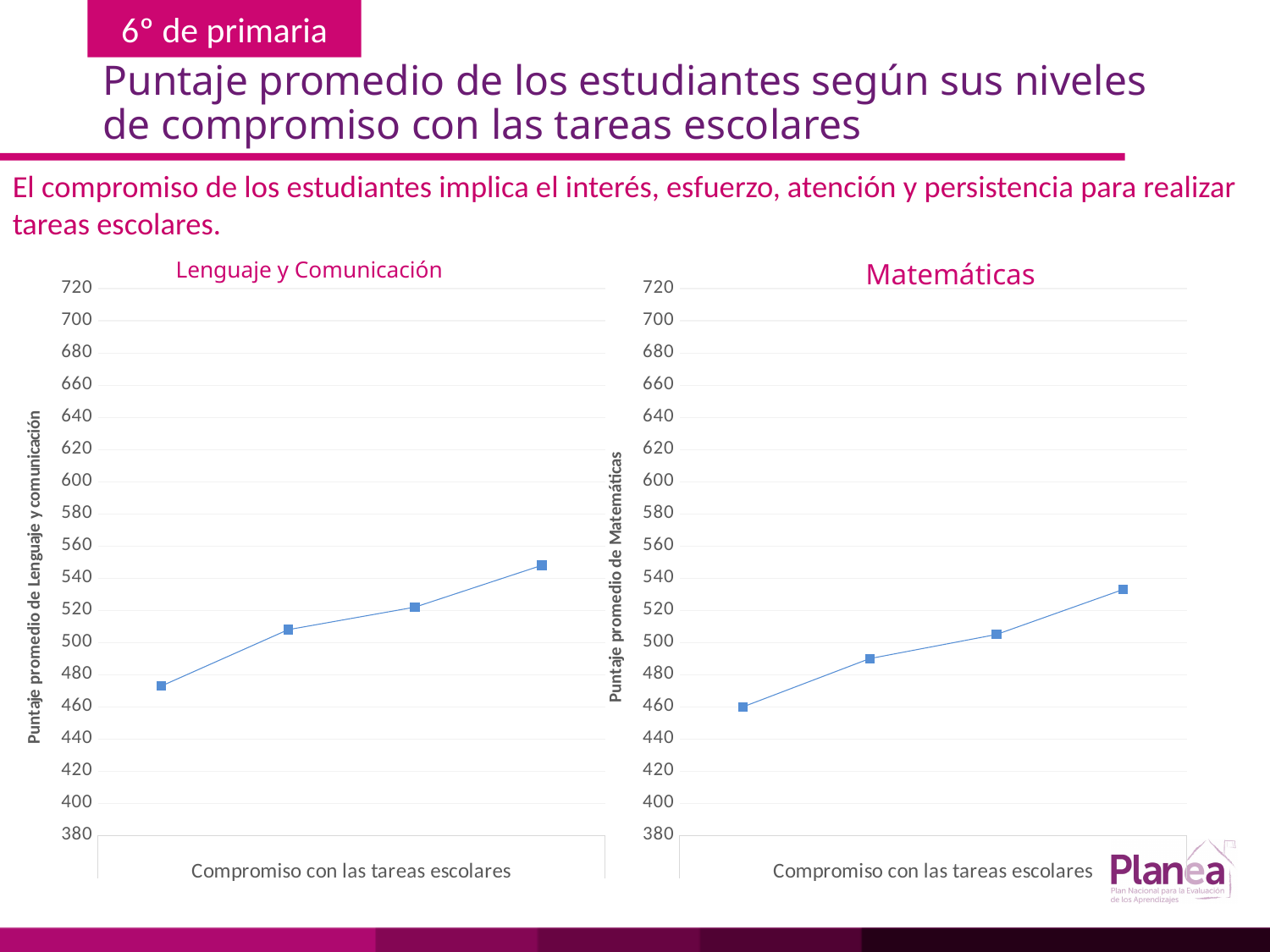
How many data points are plotted in the 'Lenguaje y Comunicación' chart? 4 How many data points are plotted in the 'Matemáticas' chart? 4 In the 'Matemáticas' chart, is the value of the second point from the left greater or less than 480? greater In the 'Matemáticas' chart, do the values rise or fall from left to right along the x axis? rise Which chart has the higher rightmost point, 'Lenguaje y Comunicación' or 'Matemáticas'? Lenguaje y Comunicación What kind of chart is the 'Lenguaje y Comunicación' chart? line chart What is the y-axis label of the 'Lenguaje y Comunicación' chart? Puntaje promedio de Lenguaje y comunicación In the 'Matemáticas' chart, is the value of the rightmost point greater or less than 520? greater What is the x-axis label of the 'Matemáticas' chart? Compromiso con las tareas escolares In the 'Lenguaje y Comunicación' chart, is the value of the rightmost point greater or less than 540? greater In the 'Lenguaje y Comunicación' chart, do the values rise or fall from left to right along the x axis? rise